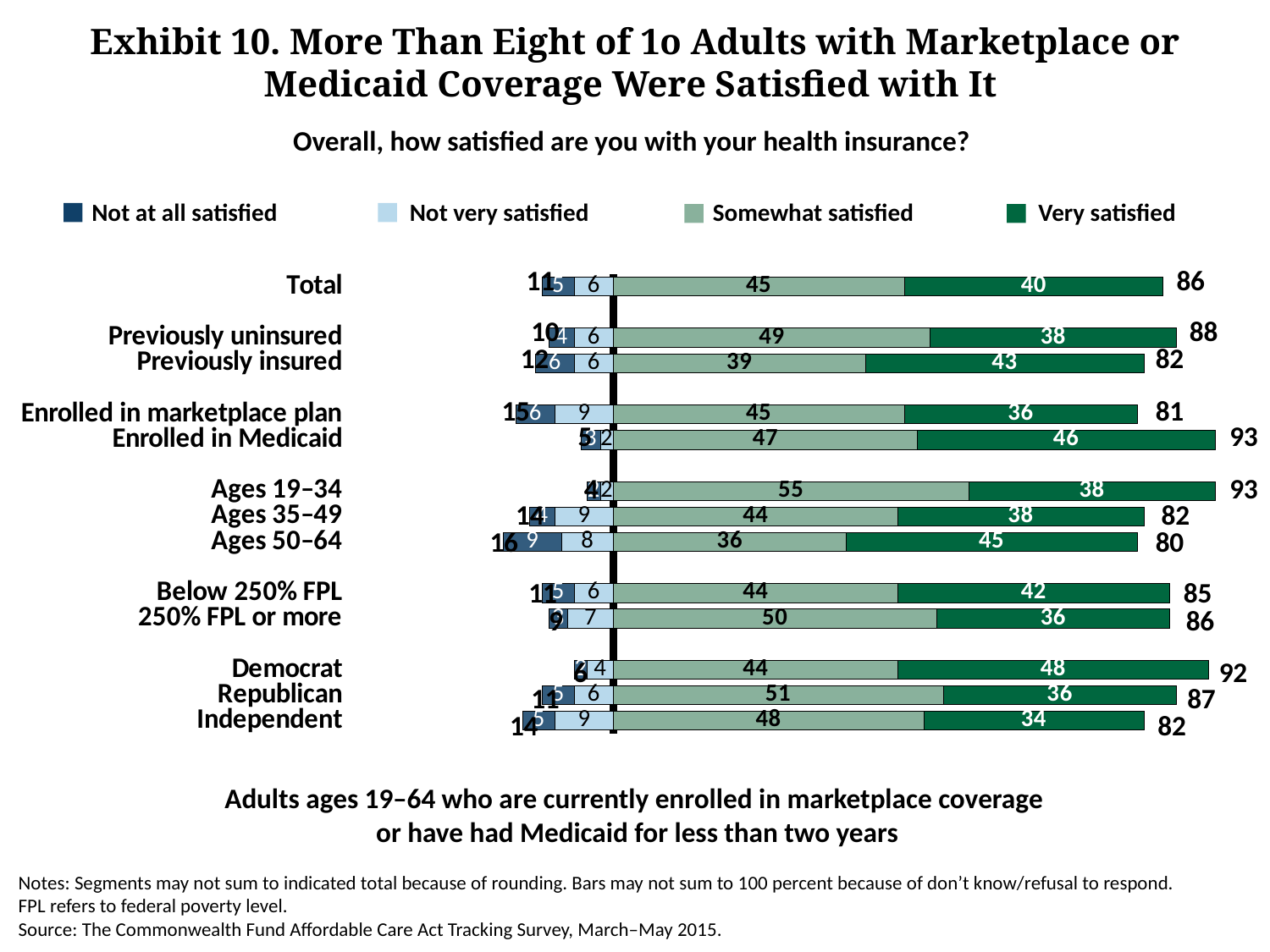
Which category has the lowest Very satisfied value? Independent How many series does the legend list? 4 Which has a larger Very satisfied value, Republican or Independent? Republican What is the difference between the Somewhat satisfied values for Previously uninsured and Previously insured? 10 What kind of chart is shown on the slide? Stacked bar chart What is the question text shown as the chart subtitle? Overall, how satisfied are you with your health insurance? Which category has the highest Very satisfied value? Democrat How many categories (groups) are plotted in the chart? 13 What is the Somewhat satisfied value for Ages 19–34? 55 Which category has the lowest total satisfied figure shown at the end of its bar? Ages 50–64 What is the Very satisfied value for Democrat? 48 What is the total satisfied figure shown at the end of the bar for Enrolled in Medicaid? 93